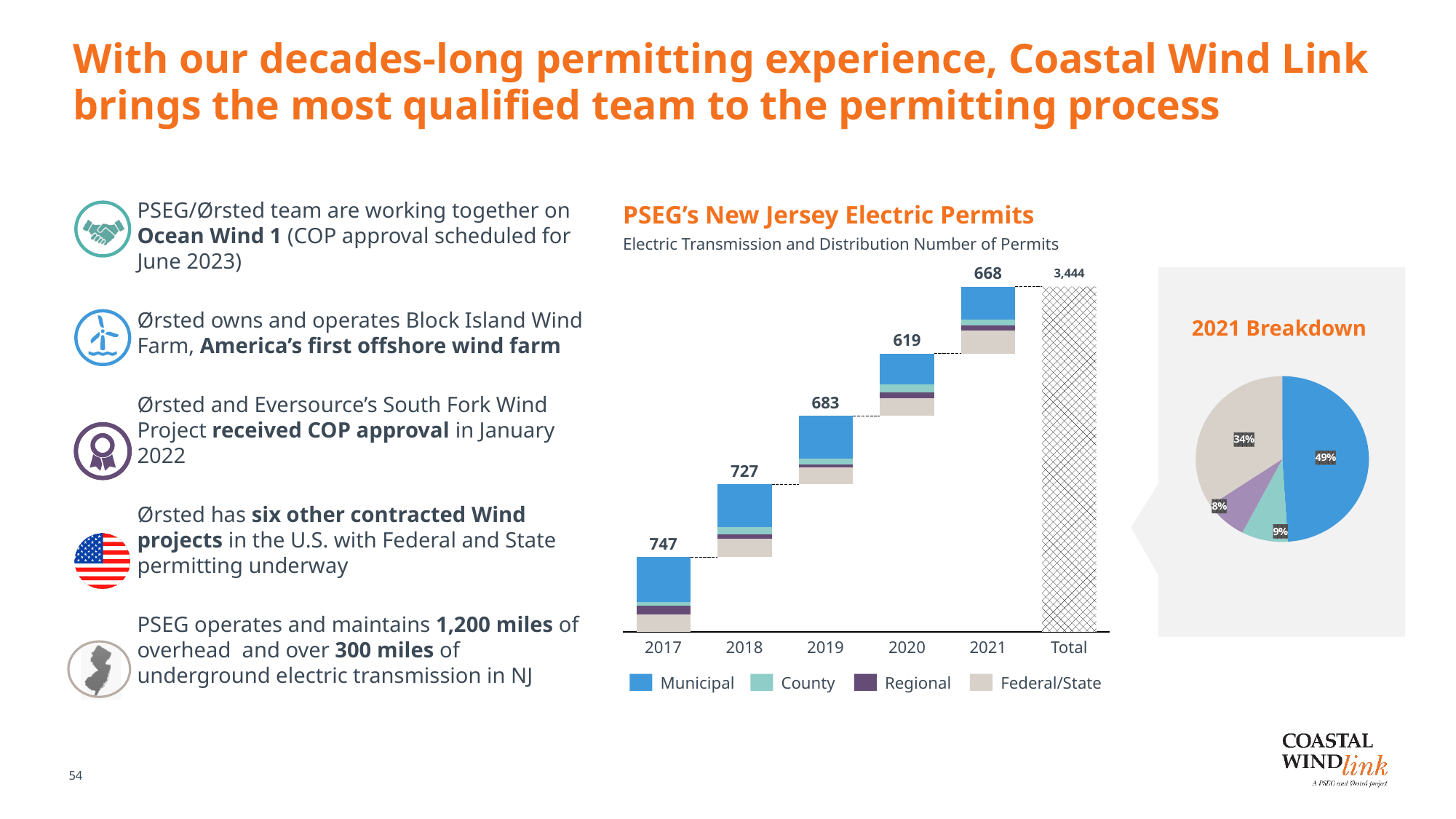
In the PSEG's New Jersey Electric Permits chart, what is the difference between the 2017 and 2018 values? 20 What kind of chart is the 2021 Breakdown chart? pie chart In the PSEG's New Jersey Electric Permits chart, which year has the highest number of permits? 2017 In the PSEG's New Jersey Electric Permits chart, what is the value shown for the Total bar? 3,444 In the 2021 Breakdown pie chart, what share does the largest (blue) slice have? 49% In the PSEG's New Jersey Electric Permits chart, what is the number of permits for 2020? 619 In the 2021 Breakdown pie chart, what share does the smallest slice have? 8% How many year categories (excluding Total) are shown on the x axis of the PSEG's New Jersey Electric Permits chart? 5 In the PSEG's New Jersey Electric Permits chart, what is the number of permits for 2017? 747 In the PSEG's New Jersey Electric Permits chart, which year has the lowest number of permits? 2020 How many series does the legend of the PSEG's New Jersey Electric Permits chart list? 4 In the PSEG's New Jersey Electric Permits chart, which is larger, the value for 2019 or the value for 2021? 2019